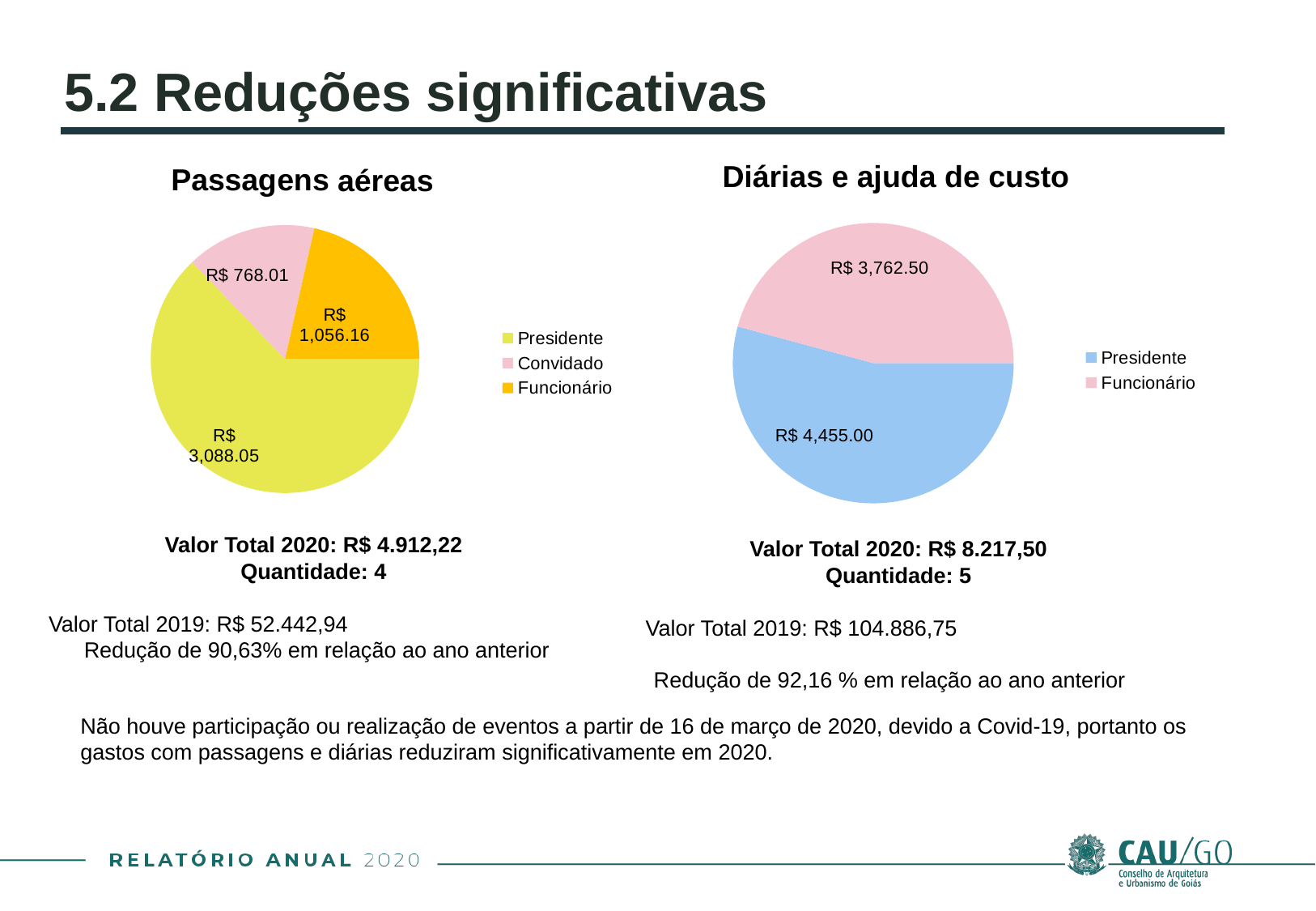
In the 'Diárias e ajuda de custo' chart, what is the value for Funcionário? R$ 3,762.50 In the 'Diárias e ajuda de custo' chart, what is the difference between the Presidente and Funcionário values? R$ 692.50 In the 'Passagens aéreas' chart, what is the value for Presidente? R$ 3,088.05 In the 'Diárias e ajuda de custo' chart, what is the value for Presidente? R$ 4,455.00 What type of chart is the 'Diárias e ajuda de custo' chart? Pie chart How many categories does the 'Passagens aéreas' chart show? 3 In the 'Passagens aéreas' chart, which category has the smallest slice? Convidado In the 'Diárias e ajuda de custo' chart, which is larger, Presidente or Funcionário? Presidente In the 'Passagens aéreas' chart, which category has the largest slice? Presidente In the 'Passagens aéreas' chart, what is the value for Funcionário? R$ 1,056.16 In the 'Passagens aéreas' chart, what is the difference between the Presidente and Funcionário values? R$ 2,031.89 In the 'Passagens aéreas' chart, what is the value for Convidado? R$ 768.01